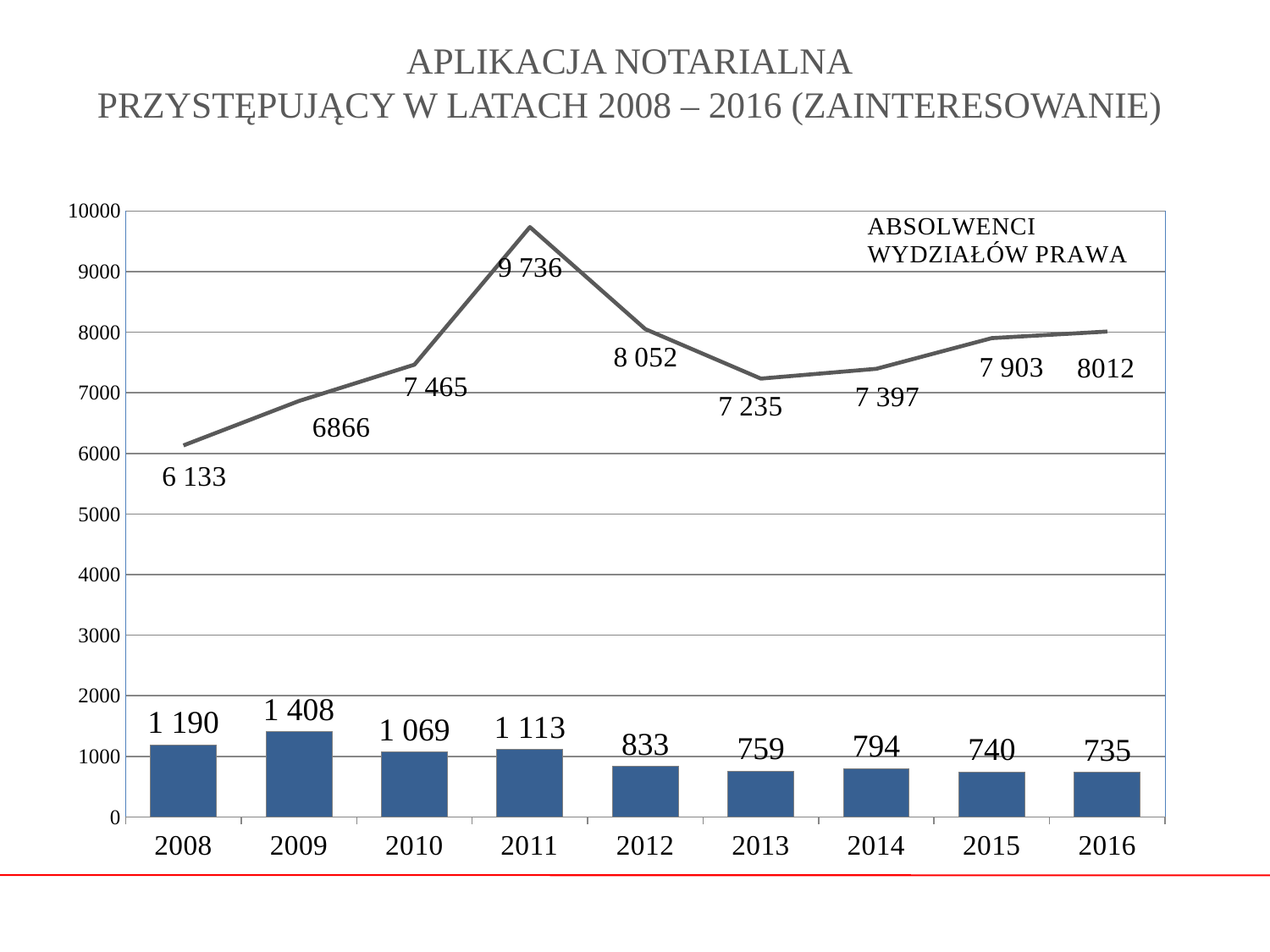
How many years are shown on the x axis? 9 In which year is the bar value the highest? 2009 What is the value of the bar for 2016? 735 What value does the line (ABSOLWENCI WYDZIAŁÓW PRAWA) show for 2011? 9 736 In which year is the line value (ABSOLWENCI WYDZIAŁÓW PRAWA) the lowest? 2008 Which year has a larger bar value, 2013 or 2014? 2014 What is the difference between the bar values for 2009 and 2010? 339 Do the bar values generally rise or fall from 2011 to 2016? fall Is the line value for 2011 greater or less than 9000? greater What label is given to the line series on the chart? ABSOLWENCI WYDZIAŁÓW PRAWA What is the value of the bar for 2009? 1 408 What kind of chart is shown on the slide? Combined bar and line chart